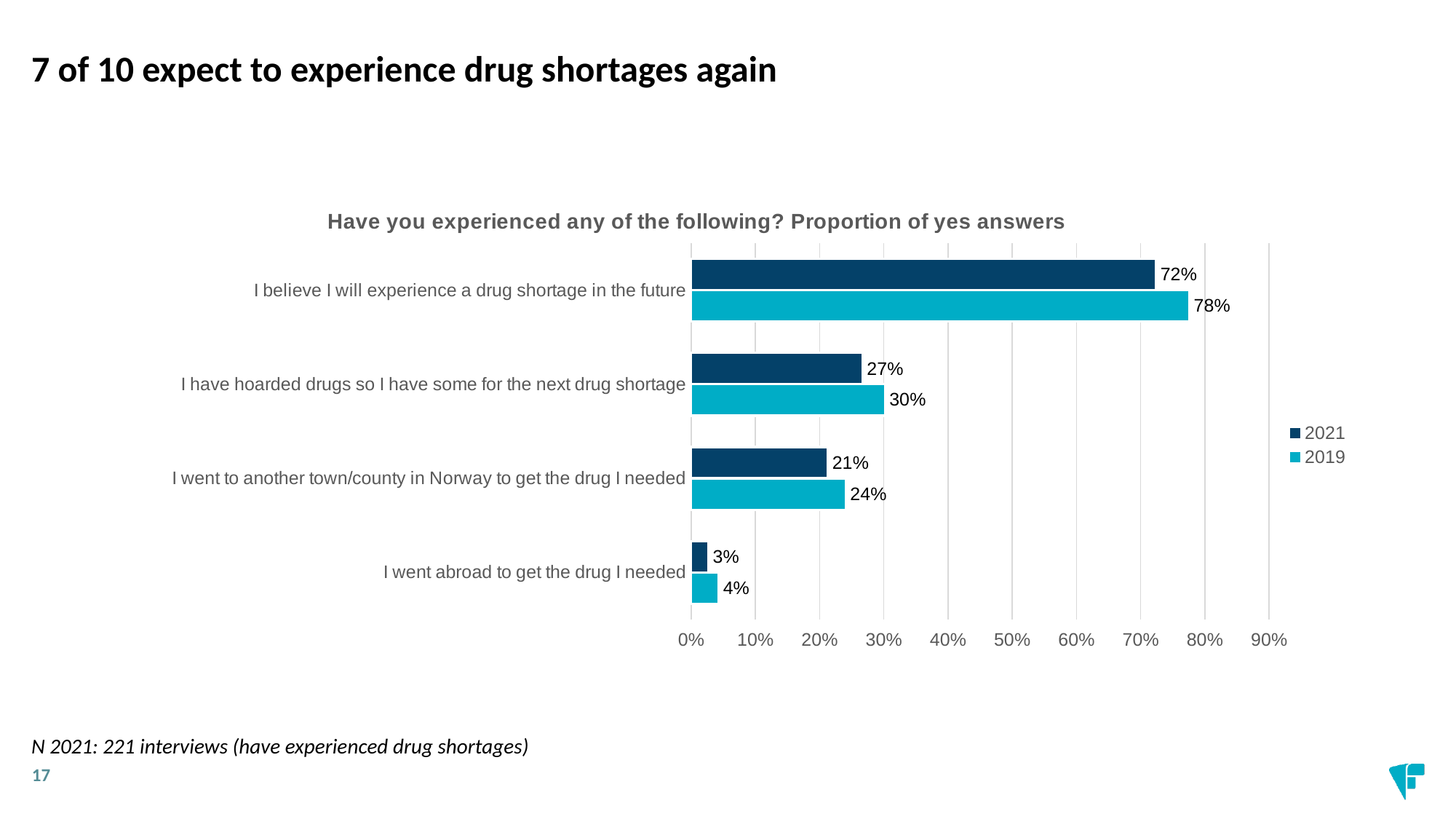
What is the difference between the 2019 and 2021 values for "I believe I will experience a drug shortage in the future"? 6% How many series does the legend list? 2 What is the title of the chart? Have you experienced any of the following? Proportion of yes answers What is the 2021 value for "I went abroad to get the drug I needed"? 3% Which is larger for "I have hoarded drugs so I have some for the next drug shortage": the 2021 value or the 2019 value? 2019 What kind of chart is shown on the slide? Bar chart What is the 2019 value for "I have hoarded drugs so I have some for the next drug shortage"? 30% Which category has the lowest 2021 value? I went abroad to get the drug I needed Which category has the highest 2019 value? I believe I will experience a drug shortage in the future What is the 2021 value for "I believe I will experience a drug shortage in the future"? 72% How many categories are shown in the chart? 4 What is the 2019 value for "I went to another town/county in Norway to get the drug I needed"? 24%